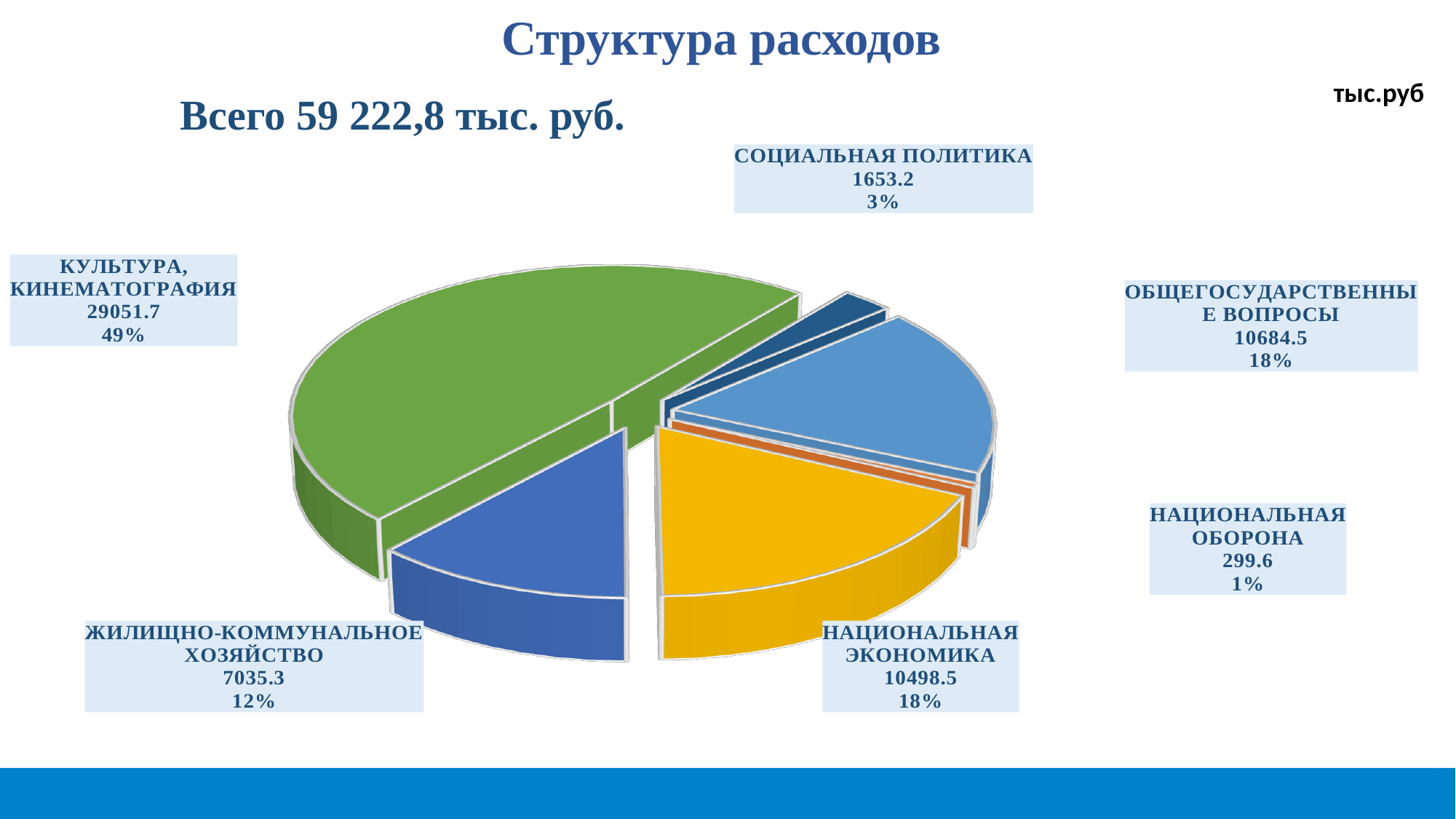
What is the title of the chart on the slide? Структура расходов How many categories (slices) does the pie chart show? 6 What is the difference between the values for ОБЩЕГОСУДАРСТВЕННЫЕ ВОПРОСЫ and НАЦИОНАЛЬНАЯ ЭКОНОМИКА? 186.0 What share of the pie does СОЦИАЛЬНАЯ ПОЛИТИКА represent? 3% What is the value for КУЛЬТУРА, КИНЕМАТОГРАФИЯ? 29051.7 What is the value for НАЦИОНАЛЬНАЯ ОБОРОНА? 299.6 What is the value for ЖИЛИЩНО-КОММУНАЛЬНОЕ ХОЗЯЙСТВО? 7035.3 Which category has the largest share of the pie? КУЛЬТУРА, КИНЕМАТОГРАФИЯ Which is larger, the value for ЖИЛИЩНО-КОММУНАЛЬНОЕ ХОЗЯЙСТВО or the value for СОЦИАЛЬНАЯ ПОЛИТИКА? ЖИЛИЩНО-КОММУНАЛЬНОЕ ХОЗЯЙСТВО What share of the pie does НАЦИОНАЛЬНАЯ ЭКОНОМИКА represent? 18% Which category has the smallest share of the pie? НАЦИОНАЛЬНАЯ ОБОРОНА What kind of chart is shown on the slide? pie chart